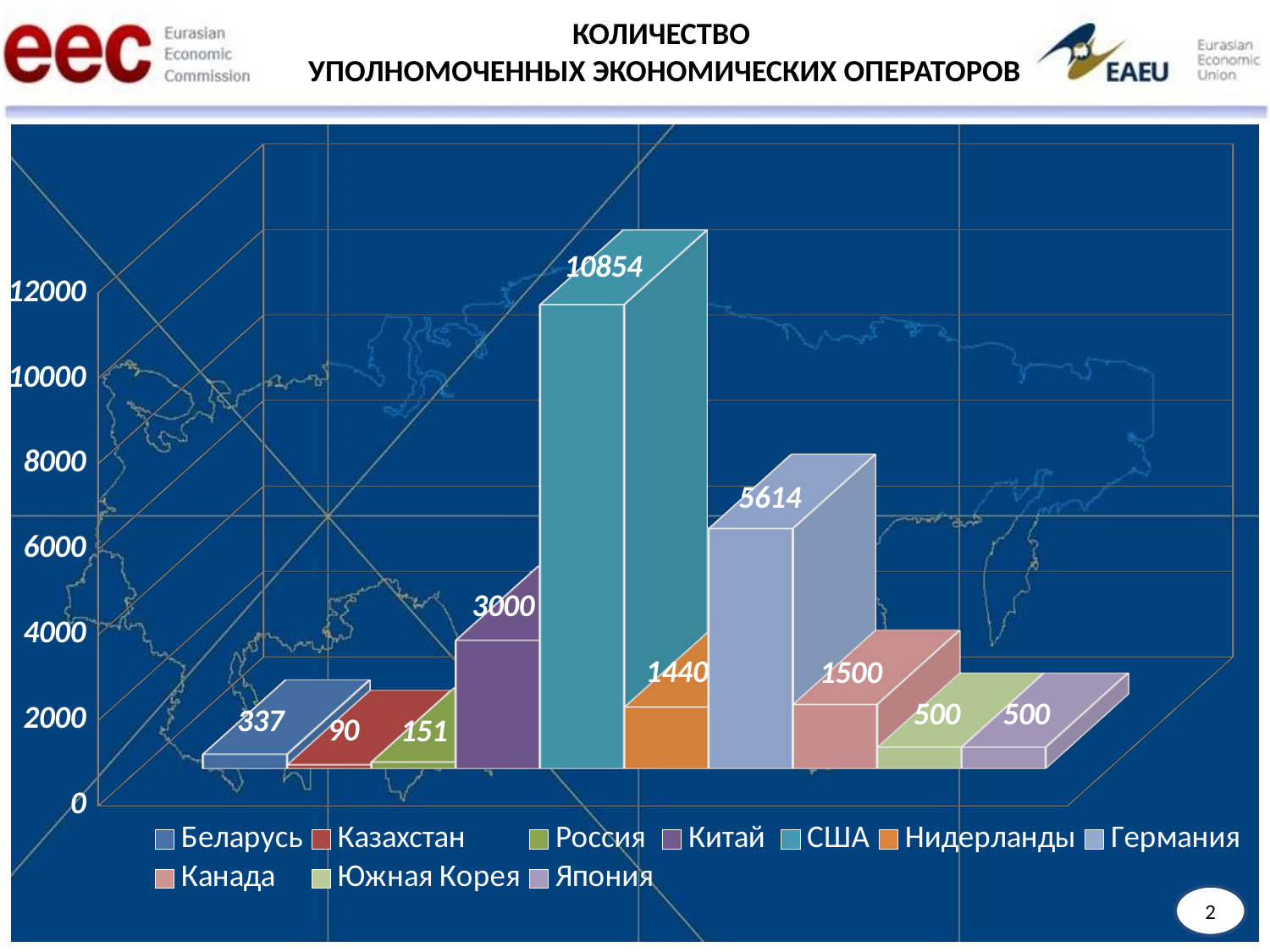
What is the difference between the values for США and Германия? 5240 Which country has the highest value on the chart? США What is the difference between the values for Беларусь and Россия? 186 How many series does the legend list? 10 What kind of chart is shown on the slide? Bar chart What is the title of the chart? КОЛИЧЕСТВО УПОЛНОМОЧЕННЫХ ЭКОНОМИЧЕСКИХ ОПЕРАТОРОВ What is the value shown for Казахстан (Kazakhstan)? 90 What is the value shown for Нидерланды (Netherlands)? 1440 Which is larger, the value for Канада or the value for Нидерланды? Канада Which country has the lowest value on the chart? Казахстан What is the value shown for США (USA)? 10854 What is the value shown for Германия (Germany)? 5614